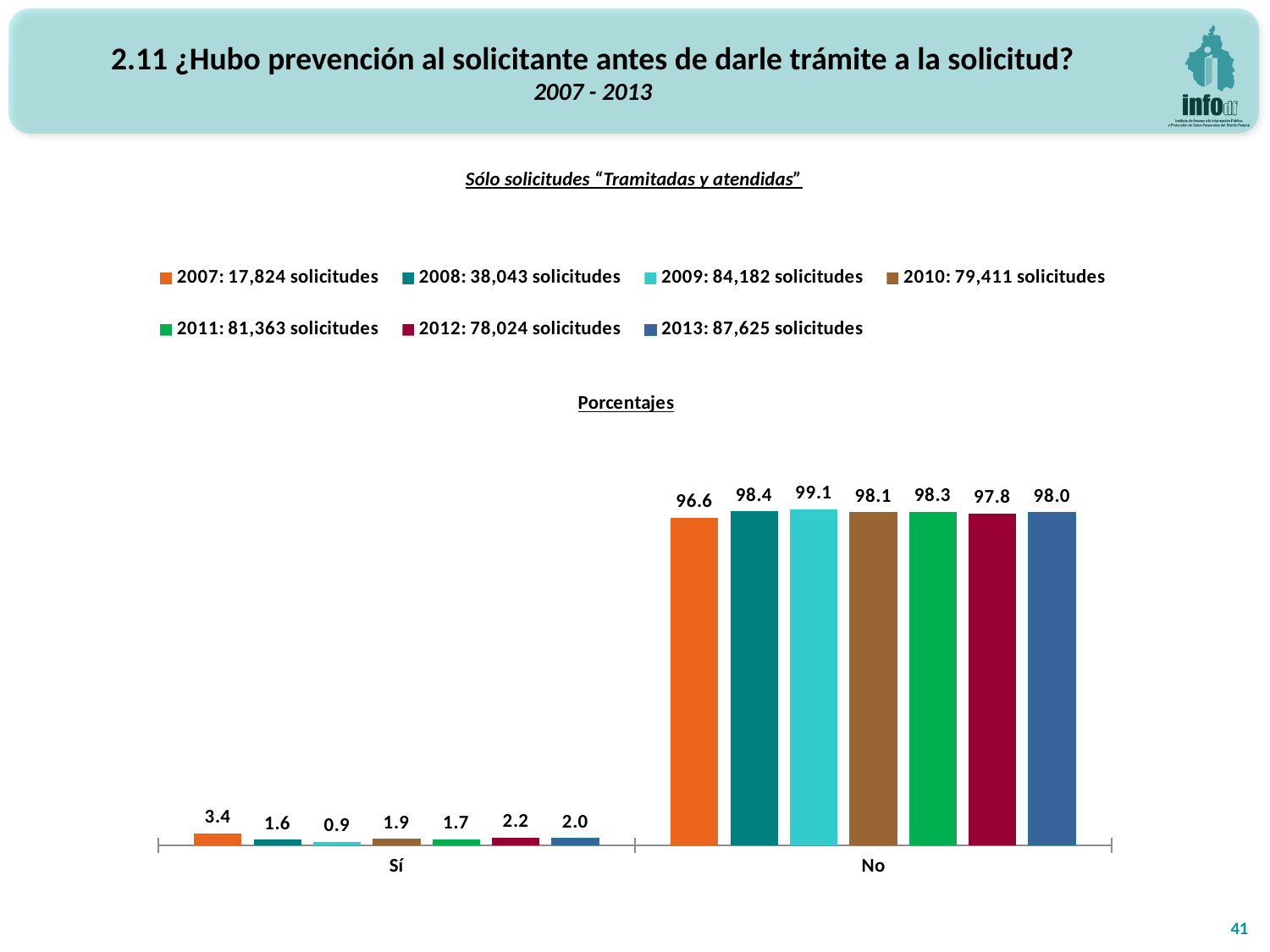
According to the legend, how many solicitudes were there in 2013? 87,625 What is the value for 2012 in the "Sí" category? 2.2 What is the value for 2009 in the "No" category? 99.1 What kind of chart is shown on the slide? Bar chart What is the difference between the 2007 and 2009 values in the "Sí" category? 2.5 Which year has the lowest value in the "No" category? 2007 Which year has the highest value in the "Sí" category? 2007 How many series does the legend list? 7 What is the value for 2007 in the "Sí" category? 3.4 Which year has the lowest value in the "Sí" category? 2009 What is the difference between the 2009 and 2007 values in the "No" category? 2.5 Which is larger in the "Sí" category: the value for 2010 or the value for 2011? 2010